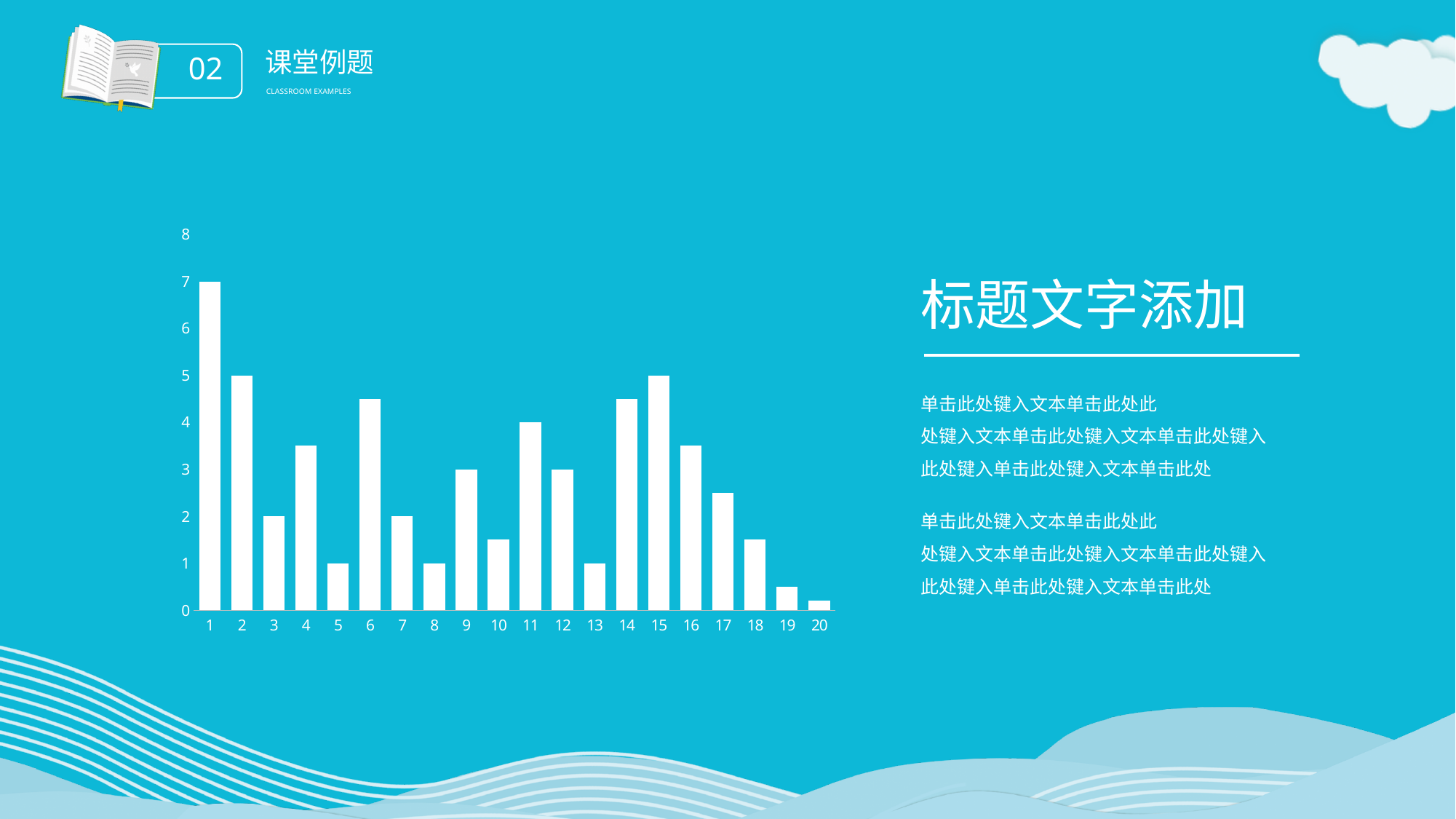
Which category has the lowest bar in the chart? 20 Which category has the highest bar in the chart? 1 What is the value for category 1? 7 Which is larger, the value for category 9 or the value for category 13? category 9 Is the value for category 19 greater or less than 1? less Is the value for category 6 greater or less than 4? greater What kind of chart is shown on the slide? bar chart What is the value for category 15? 5 How many categories are shown on the x axis of the chart? 20 What is the value for category 2? 5 What is the difference between the values for category 1 and category 2? 2 What is the value for category 11? 4